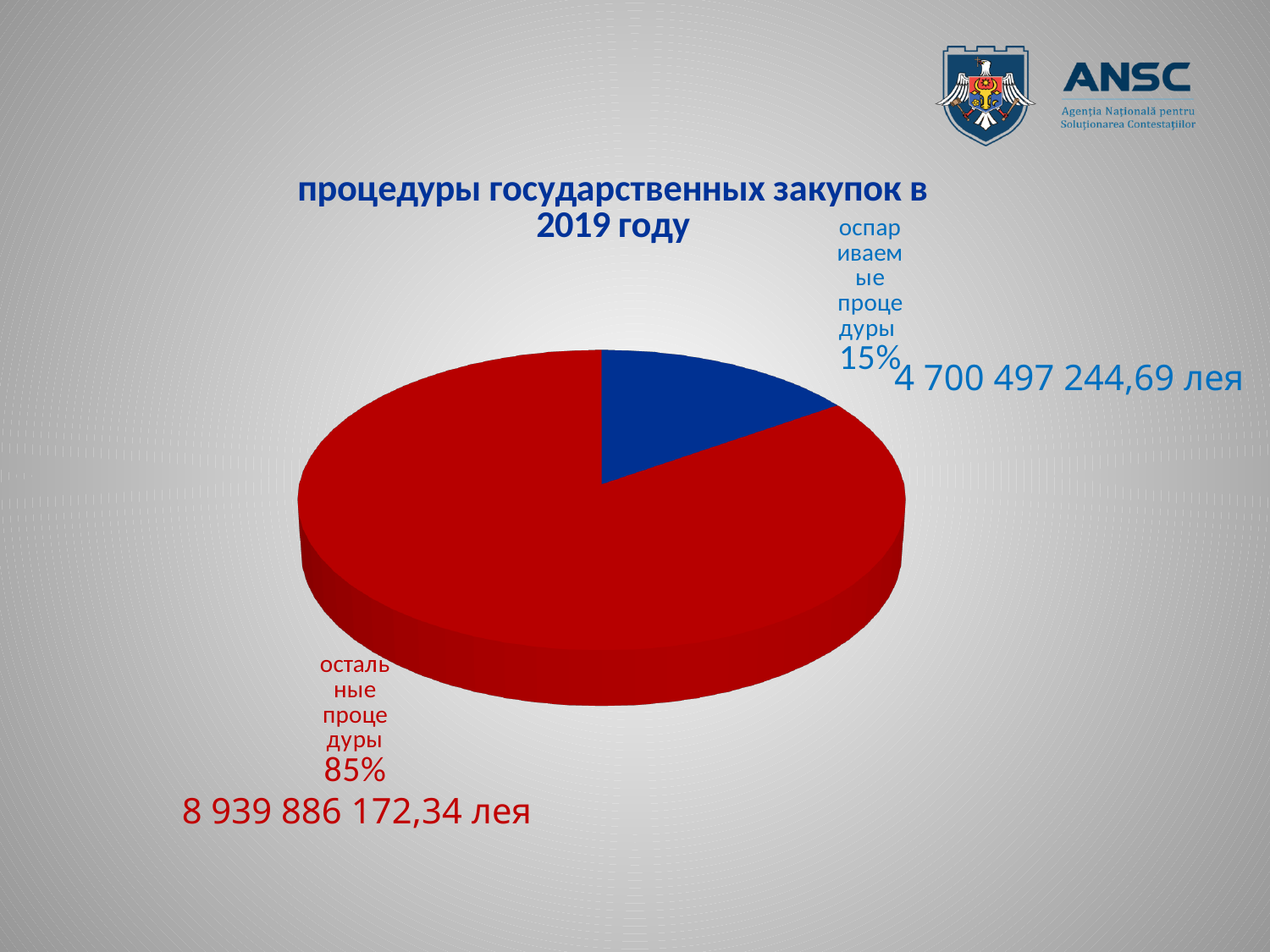
Which is larger: the share for "оспариваемые процедуры" or the share for "остальные процедуры"? остальные процедуры Which slice is the smallest in the pie chart? оспариваемые процедуры What amount in lei is printed next to the "оспариваемые процедуры" slice? 4 700 497 244,69 лея What share of the pie is labelled "оспариваемые процедуры"? 15% What is the title of the chart? процедуры государственных закупок в 2019 году How many slices does the pie chart have? 2 What amount in lei is printed next to the "остальные процедуры" slice? 8 939 886 172,34 лея What kind of chart is shown on the slide? pie chart What colour is the "оспариваемые процедуры" slice? blue Which slice is the largest in the pie chart? остальные процедуры What is the difference in percentage points between the "остальные процедуры" share and the "оспариваемые процедуры" share? 70 percentage points What share of the pie is labelled "остальные процедуры"? 85%